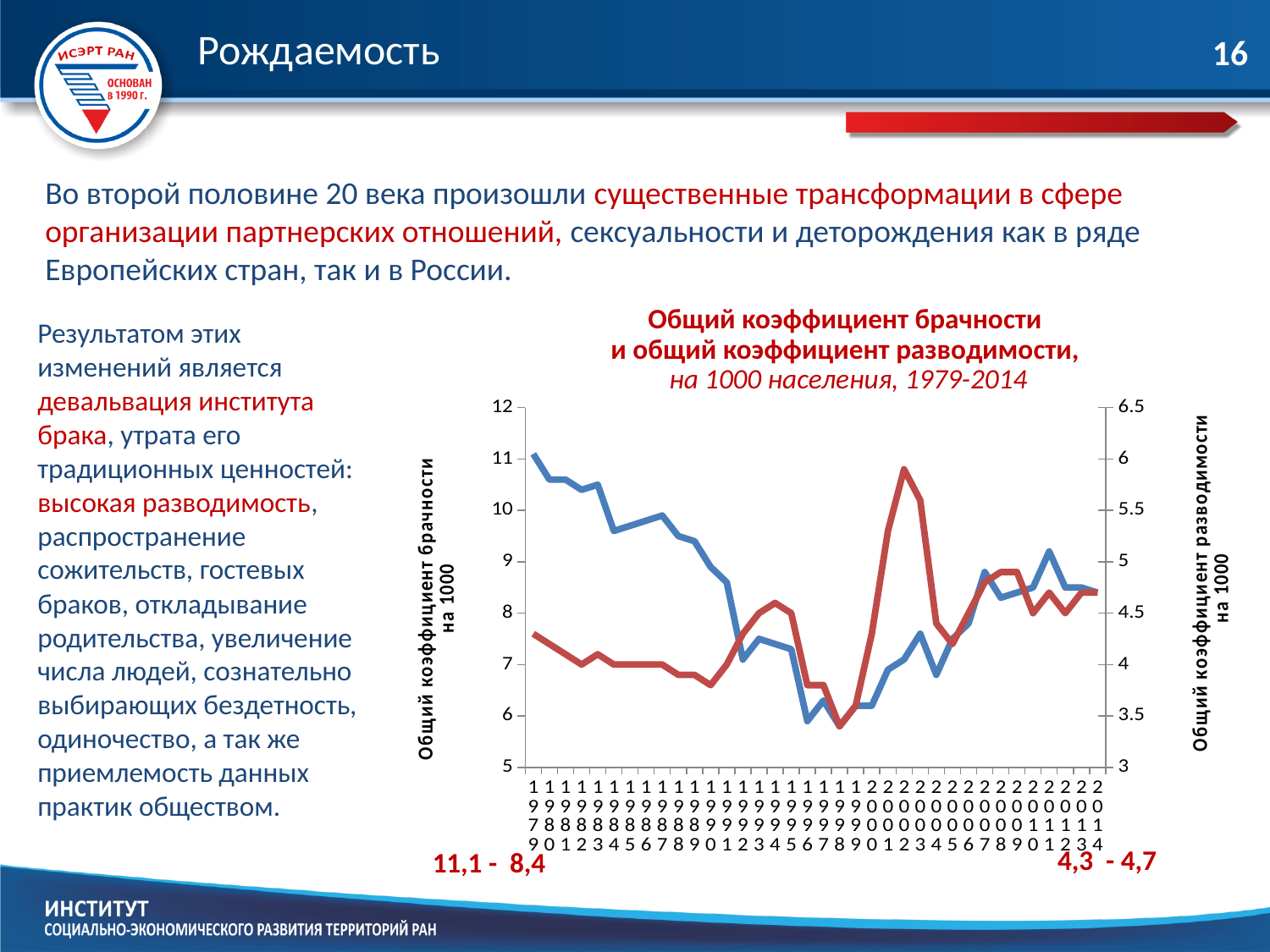
How many years does the chart's x axis cover, from 1979 to 2014? 36 What is the label of the left vertical axis of the chart? Общий коэффициент брачности на 1000 Is the marriage rate (blue line) in 1998 greater or less than 7? less In which year does the marriage rate (blue line) reach its lowest value? 1998 Does the marriage rate (blue line) rise or fall between 1979 and 1990? fall What kind of chart is shown on the slide? line chart In which year does the divorce rate (red line) reach its highest value? 2002 What is the title of the chart? Общий коэффициент брачности и общий коэффициент разводимости, на 1000 населения, 1979-2014 Is the marriage rate (blue line) in 1979 greater or less than 10? greater How many lines are plotted on the chart? 2 Is the divorce rate (red line) in 1979 greater or less than 5? less